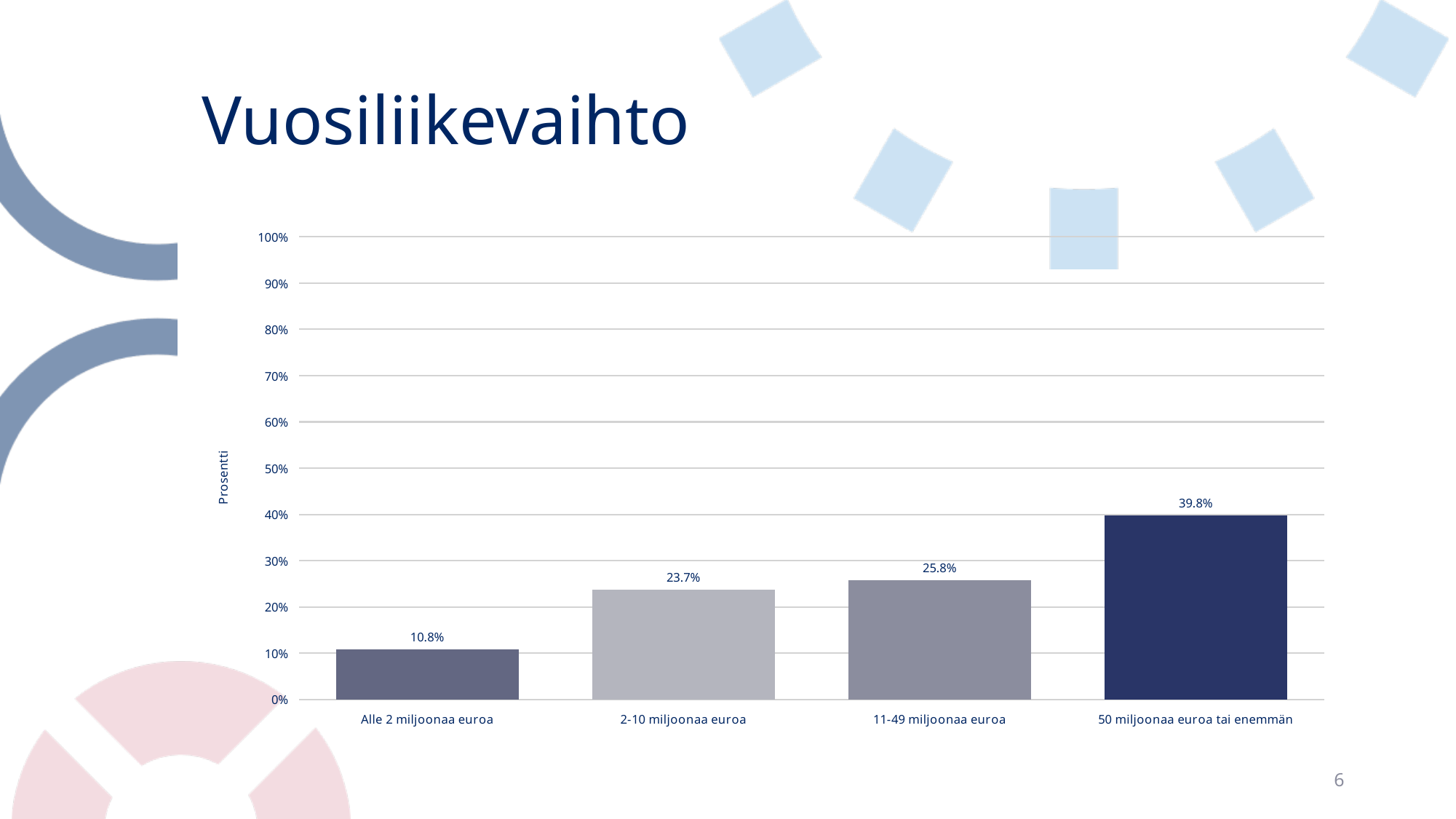
How many categories are shown on the x axis? 4 What is the value for "11-49 miljoonaa euroa"? 25.8% What is the value for "50 miljoonaa euroa tai enemmän"? 39.8% Which category has the highest value? 50 miljoonaa euroa tai enemmän Which is larger, the value for "2-10 miljoonaa euroa" or "11-49 miljoonaa euroa"? 11-49 miljoonaa euroa What kind of chart is shown on the slide? bar chart What is the difference between the values for "50 miljoonaa euroa tai enemmän" and "Alle 2 miljoonaa euroa"? 29.0% Is the value for "50 miljoonaa euroa tai enemmän" greater or less than 30%? greater What is the value for "Alle 2 miljoonaa euroa"? 10.8% What is the value for "2-10 miljoonaa euroa"? 23.7% Which category has the lowest value? Alle 2 miljoonaa euroa What is the label of the vertical axis? Prosentti